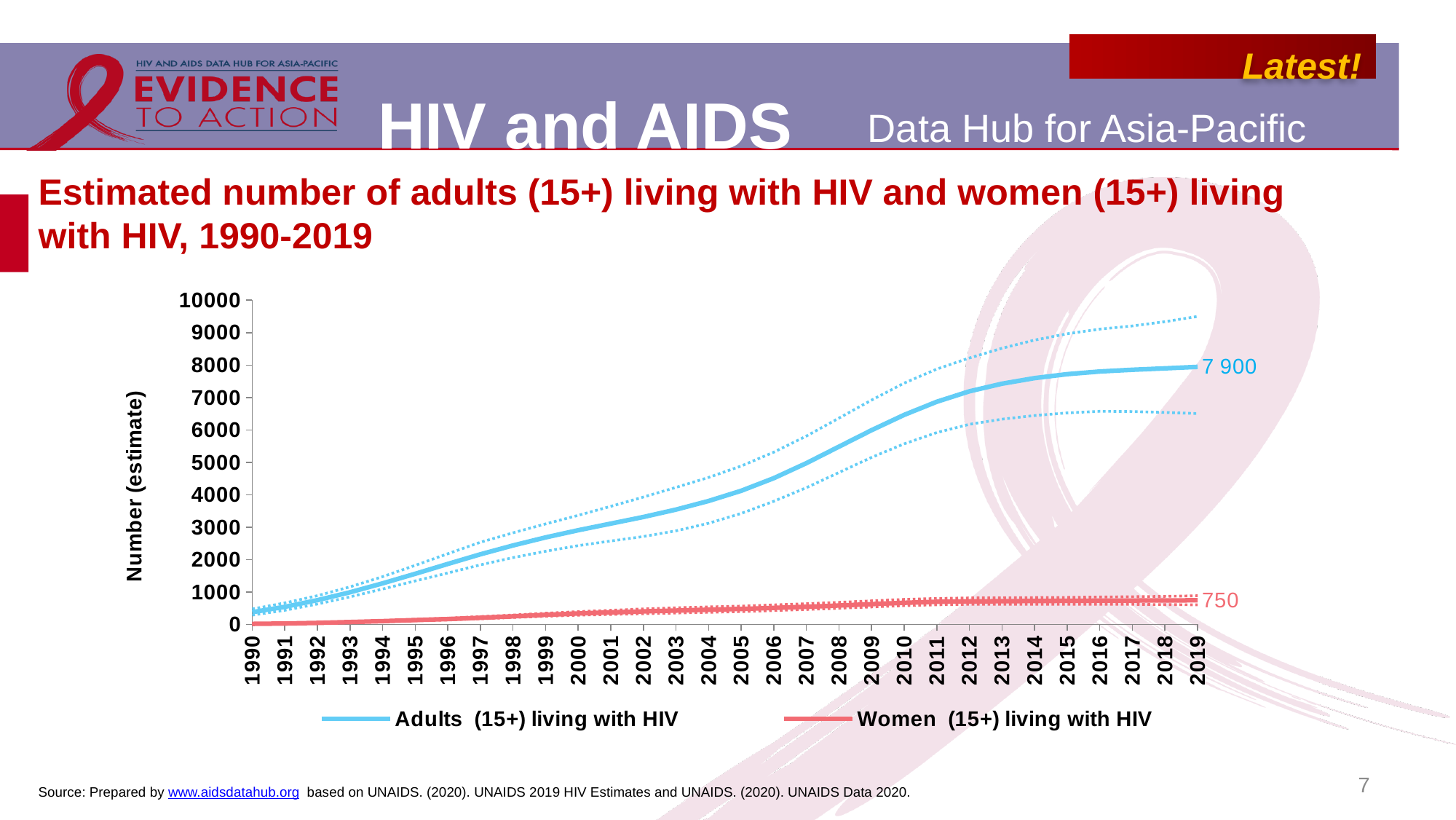
What kind of chart is shown on the slide? line chart In 2019, which series has the larger value: Adults (15+) living with HIV or Women (15+) living with HIV? Adults (15+) living with HIV Is the value for Women (15+) living with HIV in 2010 greater or less than 1000? less What is the estimated number of women (15+) living with HIV in 2019? 750 Is the value for Adults (15+) living with HIV in 2010 greater or less than 5000? greater How many series does the legend list? 2 Does the number of adults (15+) living with HIV rise or fall from 1990 to 2019? rise Is the value for Adults (15+) living with HIV in 1995 greater or less than 2000? less How many years are shown on the x axis of the chart? 30 What is the difference between the 2019 values for adults (15+) living with HIV and women (15+) living with HIV? 7 150 What is the label on the y axis of the chart? Number (estimate) What is the estimated number of adults (15+) living with HIV in 2019? 7 900